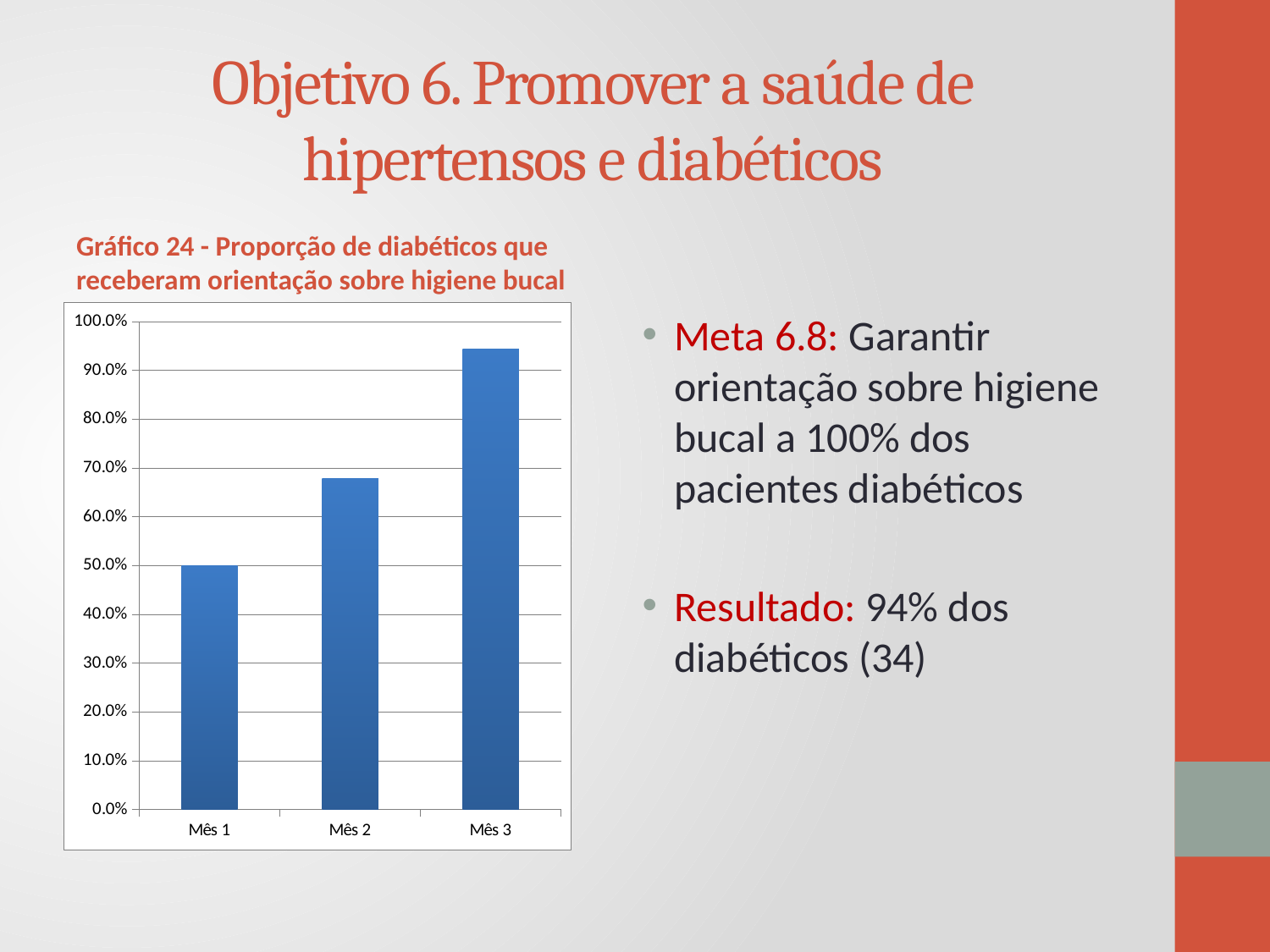
Is the value for Mês 3 greater or less than 100.0%? less What kind of chart is shown on the slide? bar chart Is the value for Mês 2 greater or less than 60.0%? greater Do the values rise or fall from Mês 1 to Mês 3? rise Which month has the highest bar in the chart? Mês 3 Which is larger, the value for Mês 2 or the value for Mês 3? Mês 3 What is the value for Mês 1 in the chart? 50.0% Is the value for Mês 2 greater or less than 70.0%? less How many bars (categories) does the chart show? 3 Which month has the lowest bar in the chart? Mês 1 What is the title of the chart on the slide? Gráfico 24 - Proporção de diabéticos que receberam orientação sobre higiene bucal